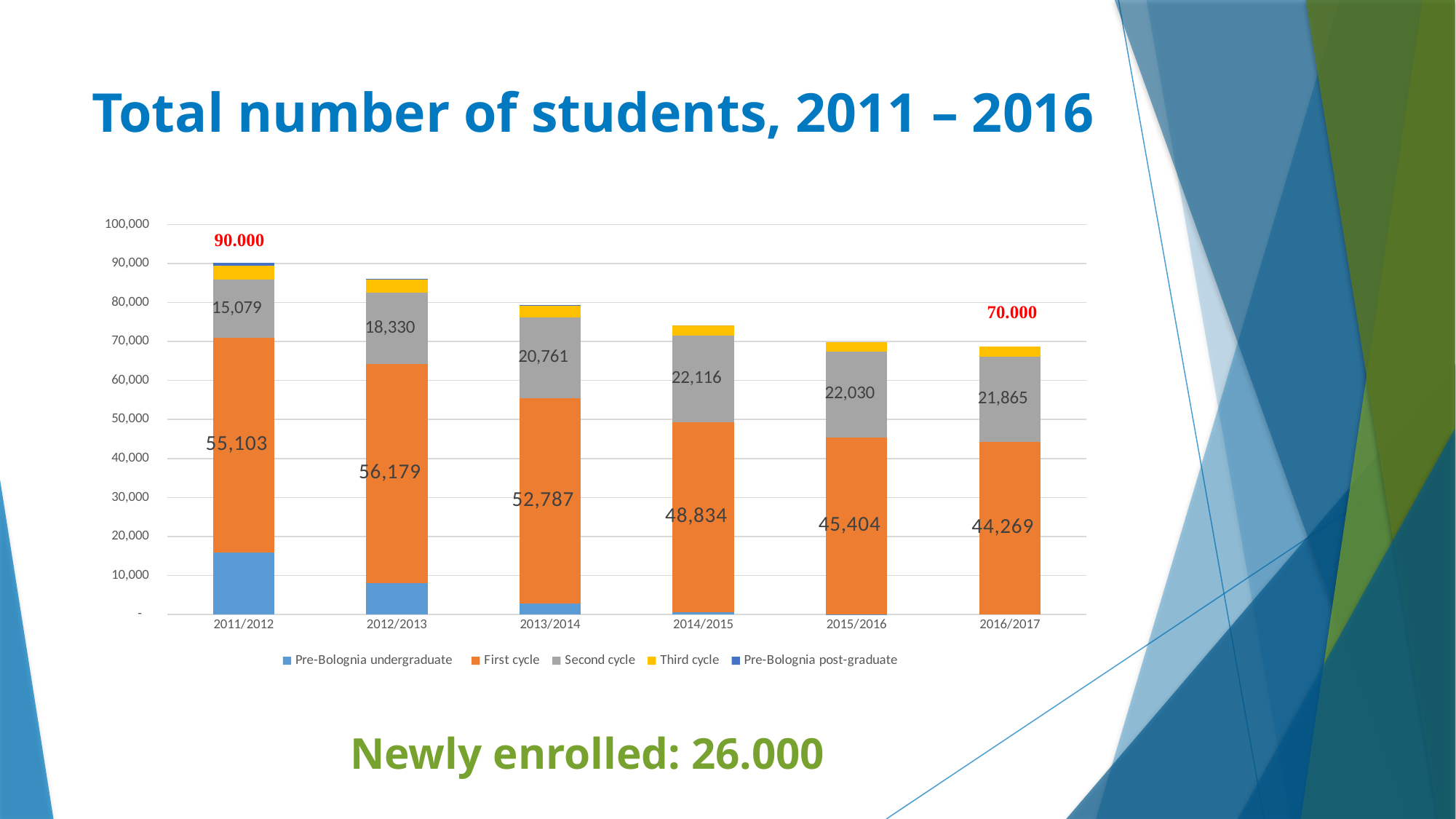
How many academic years are shown on the x axis? 6 What is the difference between the First cycle values for 2011/2012 and 2016/2017? 10,834 Do the First cycle values rise or fall from 2012/2013 to 2016/2017? fall Is the Pre-Bolognia undergraduate value for 2011/2012 greater or less than 20,000? less Which is larger, the First cycle value for 2013/2014 or for 2014/2015? 2013/2014 What is the First cycle value for 2011/2012? 55,103 Which academic year has the highest First cycle value? 2012/2013 What kind of chart is shown on the slide? Stacked bar chart How many series does the legend list? 5 Is the total height of the stacked bar for 2013/2014 greater or less than 70,000? greater Which academic year has the lowest First cycle value? 2016/2017 What is the Second cycle value for 2016/2017? 21,865